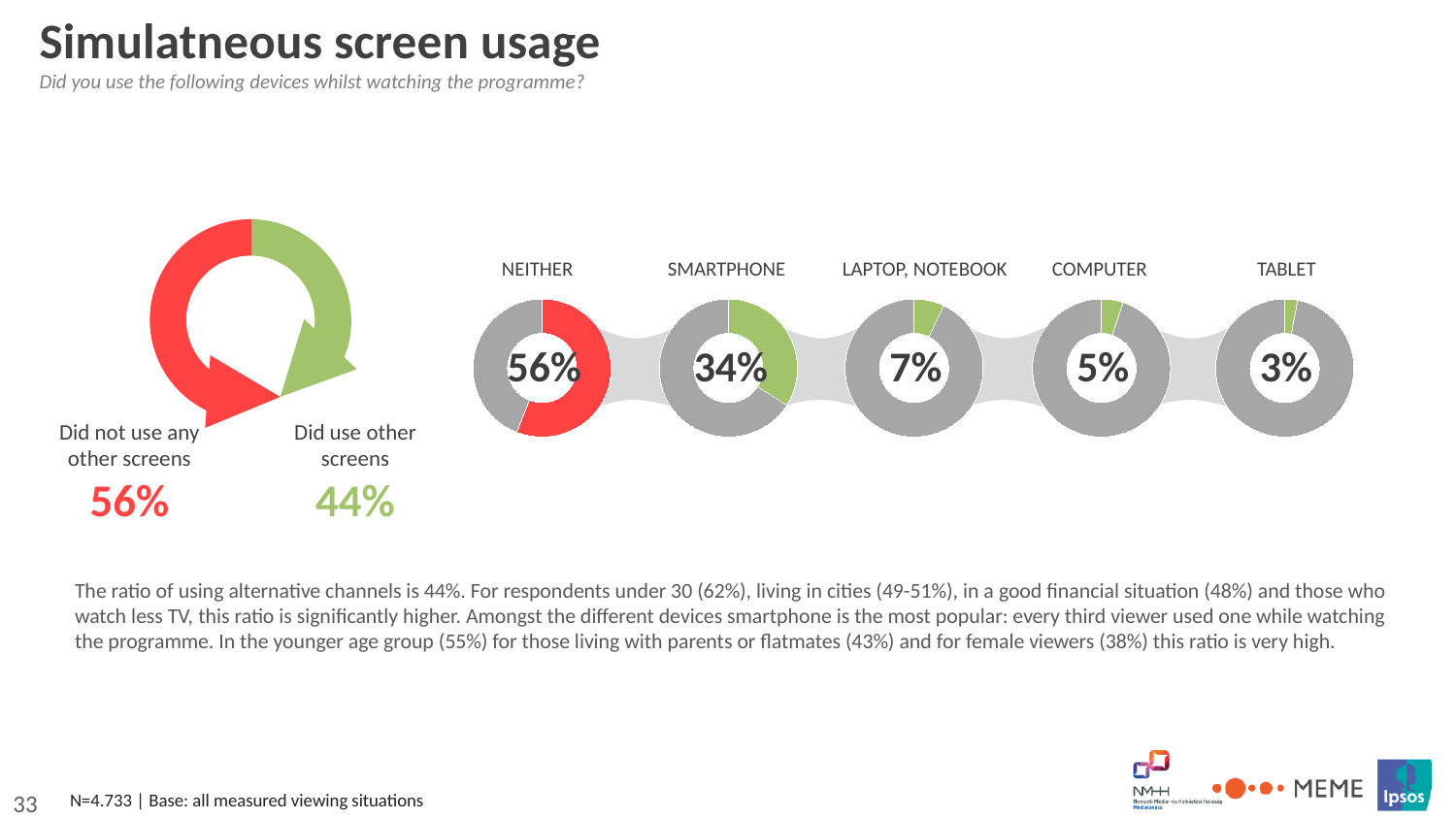
In the row of small donut charts on the right, what is the difference between SMARTPHONE and COMPUTER? 29% In the row of small donut charts on the right, which device has the lowest value? TABLET What is the title of the slide? Simulatneous screen usage In the large donut chart on the left, what percentage did not use any other screens? 56% In the row of small donut charts on the right, which category has the highest value? NEITHER In the row of small donut charts on the right, what is the value for TABLET? 3% In the row of small donut charts on the right, what is the value for SMARTPHONE? 34% How many small donut charts are in the row on the right? 5 In the large donut chart on the left, what is the difference between the share that did not use any other screens and the share that did? 12% In the large donut chart on the left, which is larger: 'Did not use any other screens' or 'Did use other screens'? Did not use any other screens In the row of small donut charts on the right, what is the value for LAPTOP, NOTEBOOK? 7% In the large donut chart on the left, what percentage did use other screens? 44%